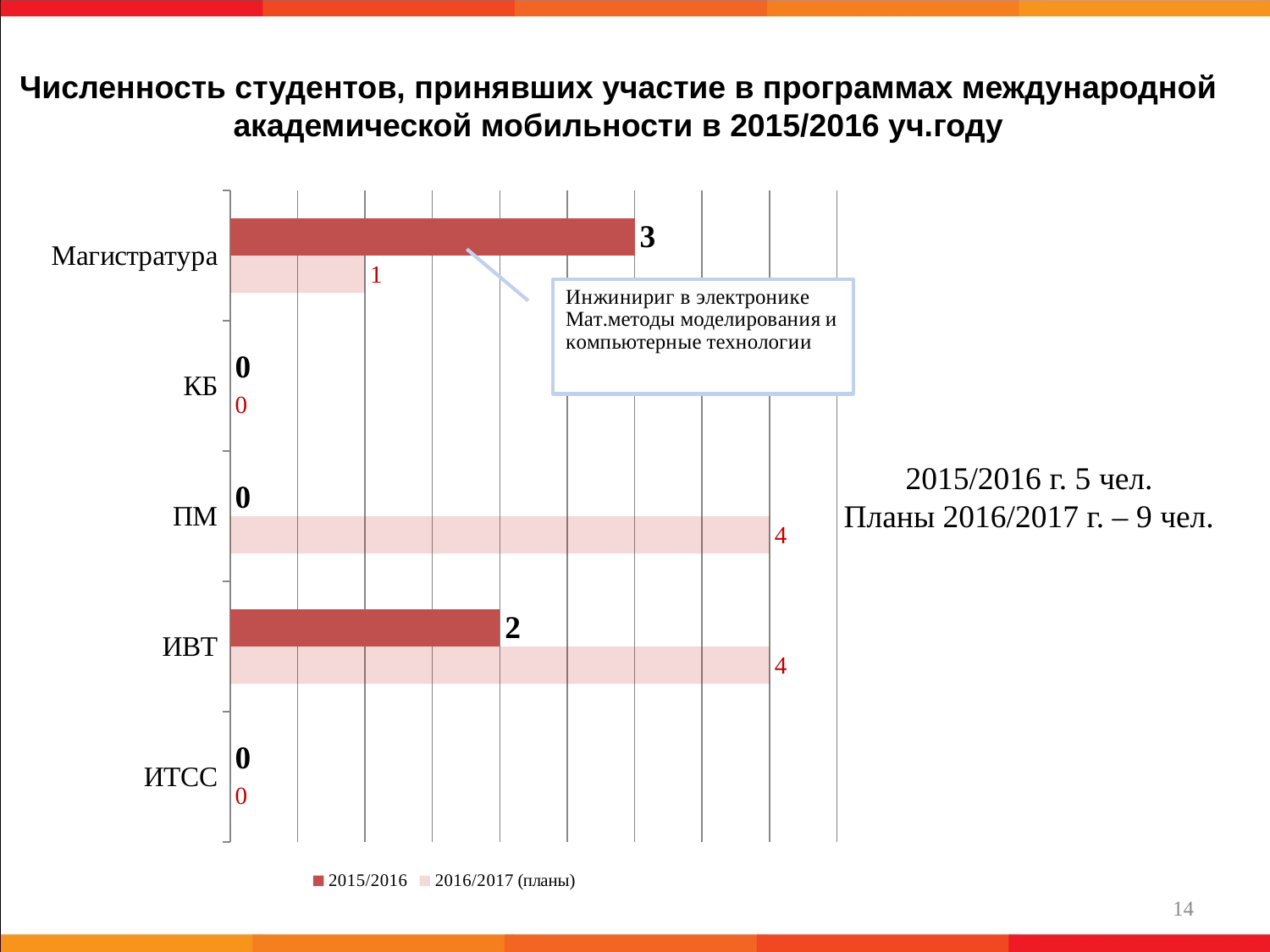
What are the two legend entries of the chart? 2015/2016 and 2016/2017 (планы) How many series does the legend list? 2 What is the 2016/2017 (планы) value for Магистратура? 1 What is the 2015/2016 value for Магистратура? 3 What is the 2015/2016 value for ИВТ? 2 What type of chart is shown on the slide? bar chart Which category has the highest 2015/2016 value? Магистратура What is the 2016/2017 (планы) value for ПМ? 4 For Магистратура, which is larger: the 2015/2016 value or the 2016/2017 (планы) value? 2015/2016 What is the difference between the 2016/2017 (планы) value and the 2015/2016 value for ИВТ? 2 How many categories are shown on the chart? 5 What is the 2015/2016 value for ИТСС? 0